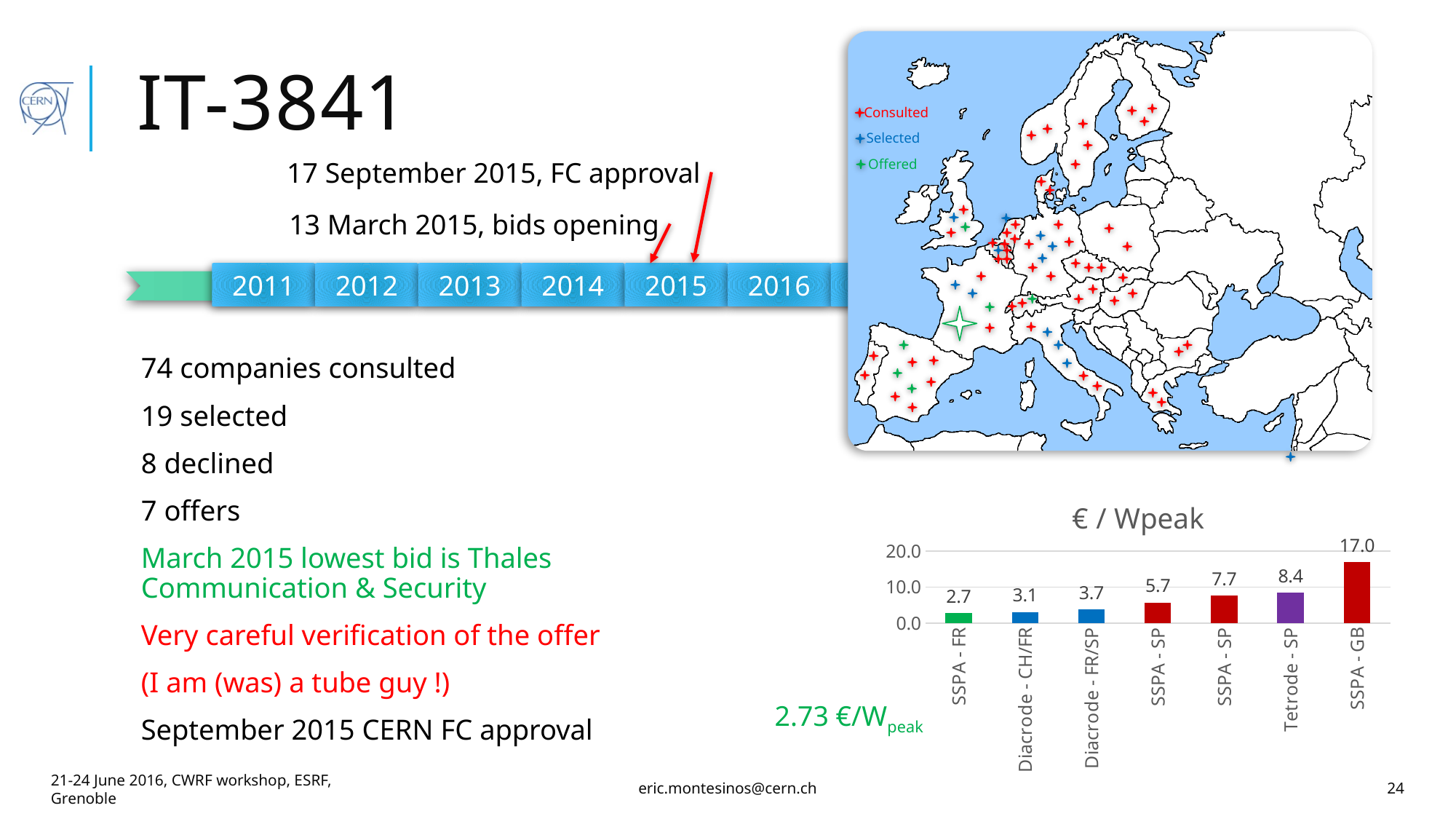
In the € / Wpeak chart, what is the value for Tetrode - SP? 8.4 In the € / Wpeak chart, what is the value for SSPA - FR? 2.7 In the € / Wpeak chart, which category has the lowest value? SSPA - FR What is the title of the bar chart on the slide? € / Wpeak In the € / Wpeak chart, what is the value for Diacrode - CH/FR? 3.1 In the € / Wpeak chart, what is the value for SSPA - GB? 17.0 How many bars are plotted in the € / Wpeak chart? 7 In the € / Wpeak chart, what is the difference between the values for SSPA - GB and Tetrode - SP? 8.6 In the € / Wpeak chart, what is the value for Diacrode - FR/SP? 3.7 In the € / Wpeak chart, which category has the highest value? SSPA - GB In the € / Wpeak chart, which is larger: the value for Diacrode - FR/SP or the value for Tetrode - SP? Tetrode - SP What kind of chart is the € / Wpeak chart? bar chart